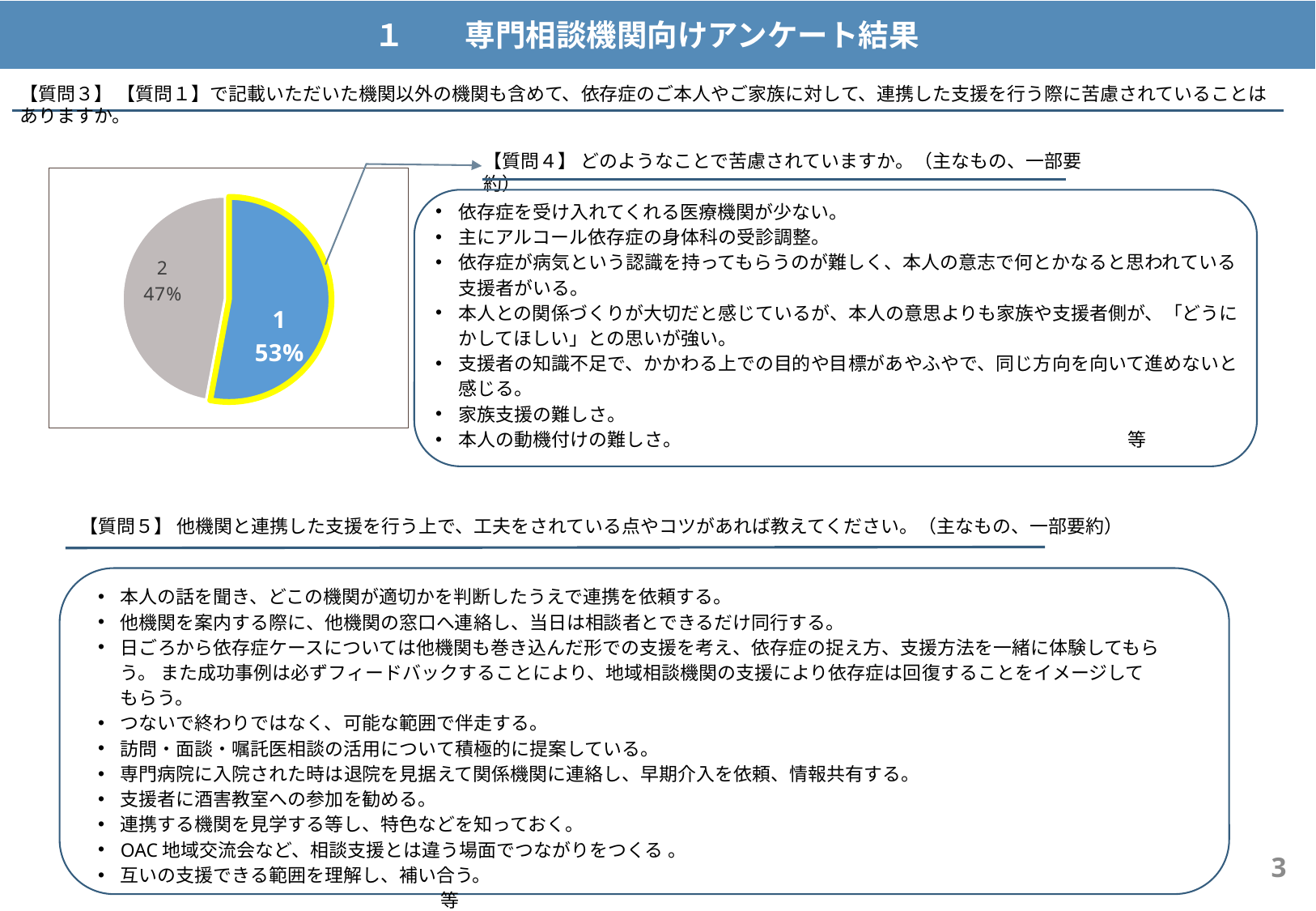
What is the difference in percentage points between slice 1 and slice 2 in the pie chart? 6 What colour is slice 1 in the pie chart? blue What percentage is shown for slice 2 in the pie chart? 47% What kind of chart is shown on the slide? pie chart What percentage is shown for slice 1 in the pie chart? 53% Which is larger in the pie chart, slice 1 or slice 2? 1 What colour is slice 2 in the pie chart? gray Is the value for slice 1 in the pie chart greater or less than 50%? greater Is the value for slice 2 in the pie chart greater or less than 50%? less Which slice of the pie chart is the largest? 1 Which slice of the pie chart is the smallest? 2 How many slices does the pie chart have? 2